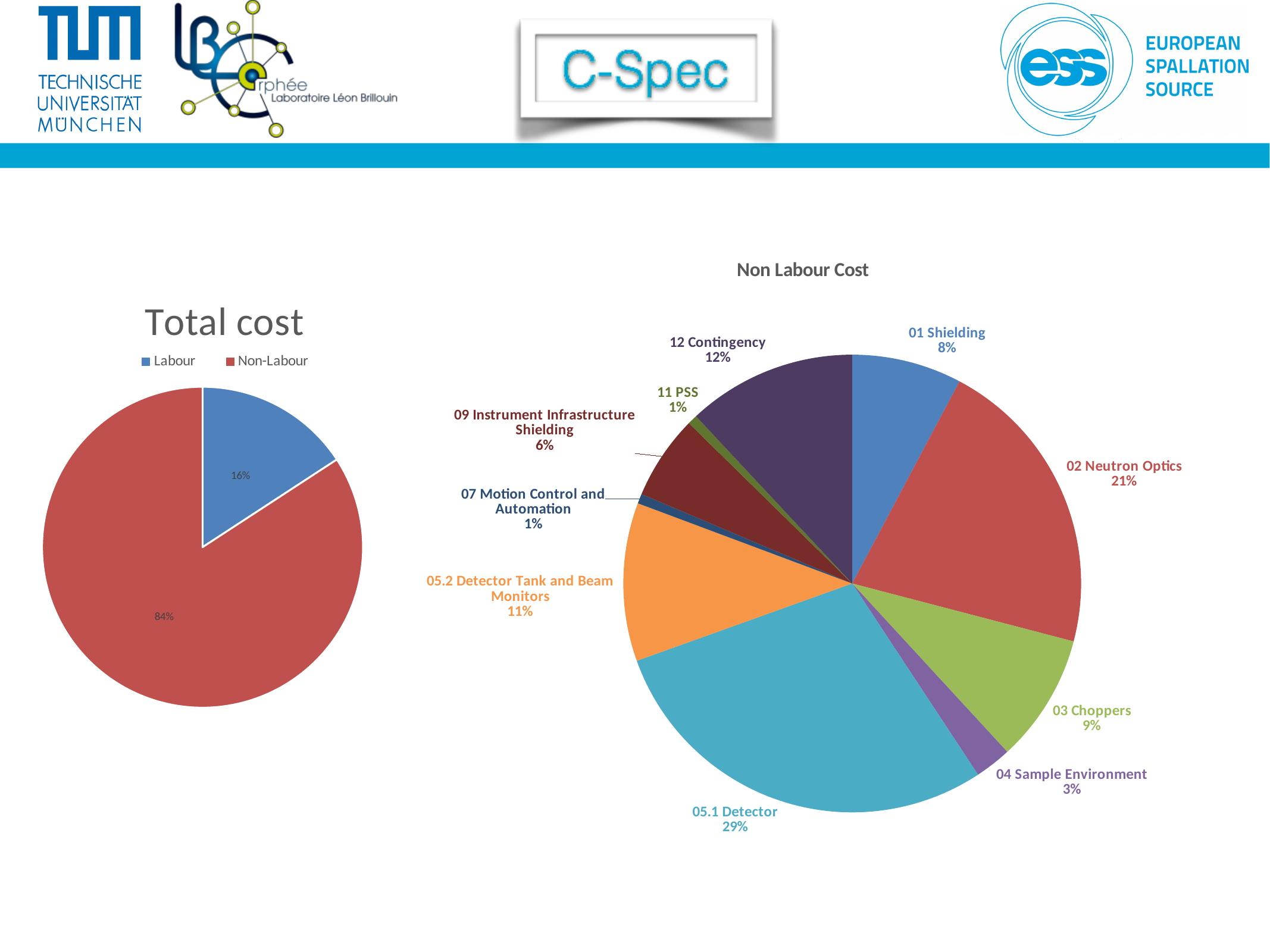
In the Non Labour Cost chart, what share is 02 Neutron Optics? 21% How many entries does the legend of the Total cost chart list? 2 In the Non Labour Cost chart, what is the difference in percentage points between 12 Contingency and 01 Shielding? 4 What kind of chart is the Total cost chart? Pie chart In the Total cost chart, what share of the pie is Labour? 16% In the Non Labour Cost chart, what share is 05.2 Detector Tank and Beam Monitors? 11% In the Non Labour Cost chart, how many categories are shown? 10 In the Total cost chart, which slice is larger, Labour or Non-Labour? Non-Labour In the Non Labour Cost chart, which is larger, 03 Choppers or 04 Sample Environment? 03 Choppers In the Non Labour Cost chart, which category has the largest slice? 05.1 Detector